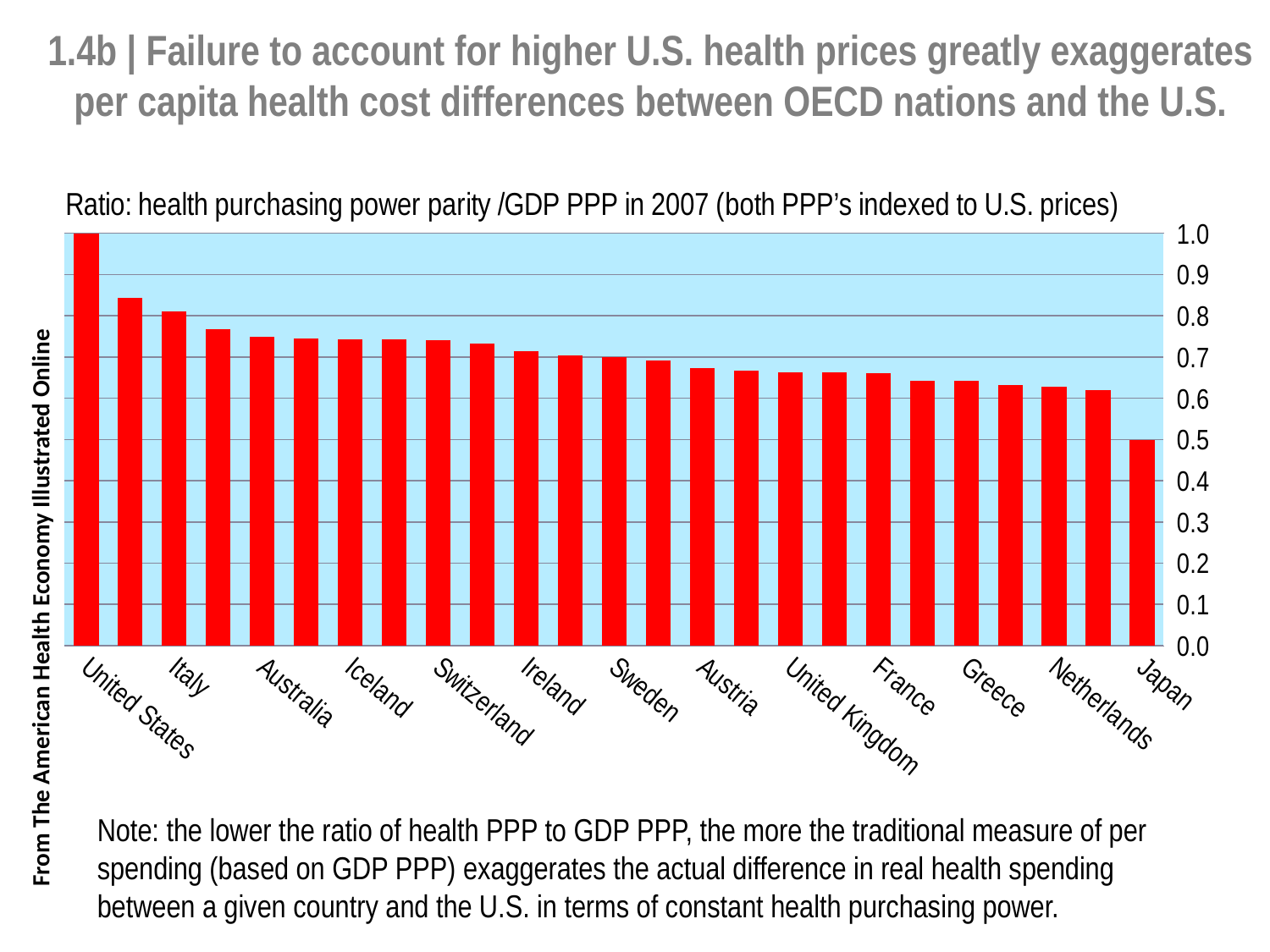
Which country has the highest ratio of health PPP to GDP PPP? United States Do the bar values rise or fall moving from left to right along the x axis? fall Is the ratio for Australia greater or less than 0.7? greater Is the ratio for the United Kingdom greater or less than 0.7? less What kind of chart is shown on the slide? bar chart Is the ratio for Netherlands greater or less than 0.6? greater Which has the larger ratio, Italy or Australia? Italy Which country has the lowest ratio of health PPP to GDP PPP? Japan What is the ratio value for the United States? 1.0 How many bars (countries) are plotted in the chart? 25